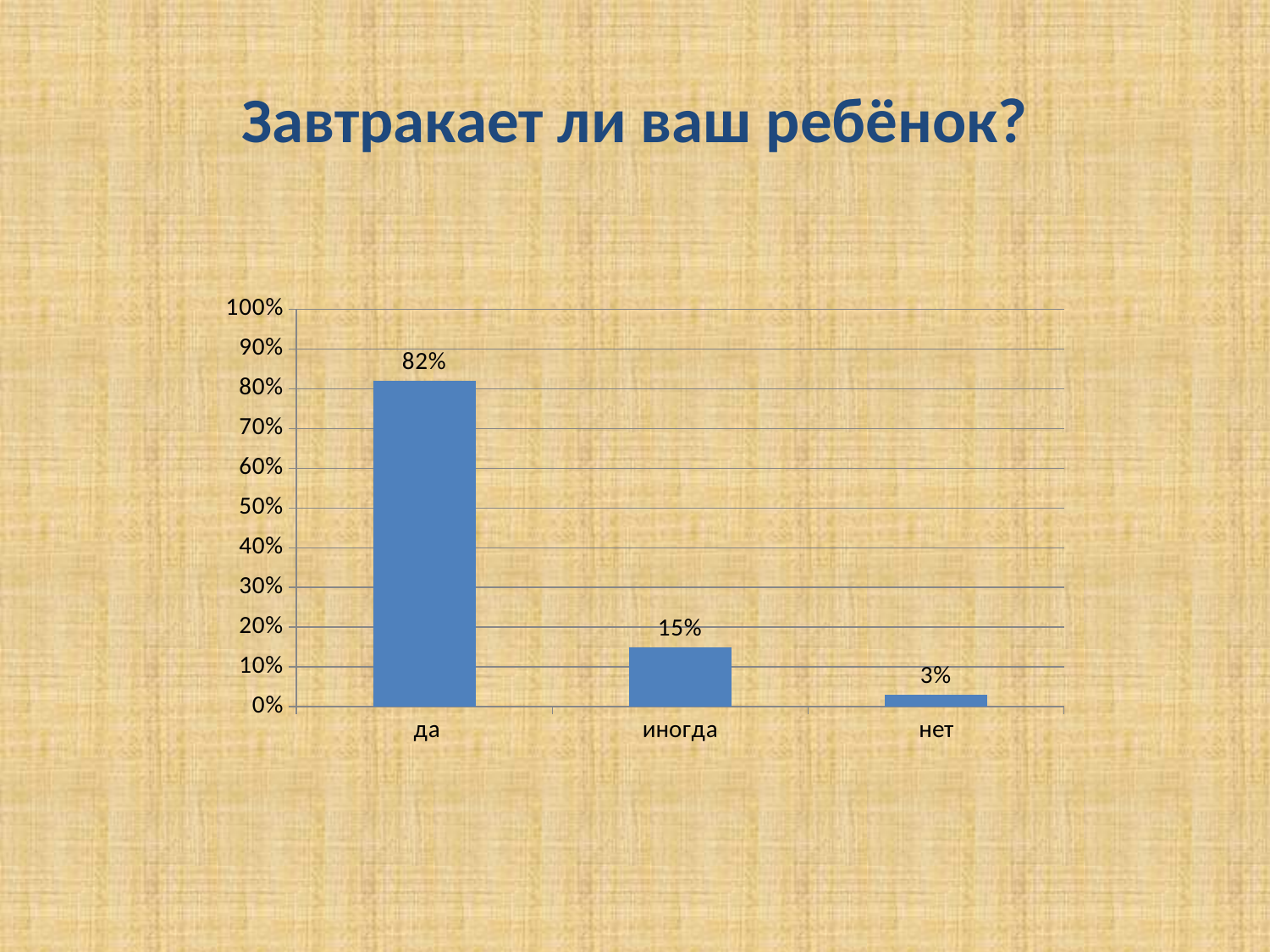
Which category has the highest value? да What is the value for "да"? 82% Which category has the lowest value? нет How many categories are shown on the x axis? 3 What kind of chart is shown on the slide? bar chart What is the title of the slide? Завтракает ли ваш ребёнок? What is the difference between the values for "иногда" and "нет"? 12% Which is larger, the value for "иногда" or the value for "нет"? иногда Is the value for "да" greater or less than 50%? greater What is the difference between the values for "да" and "иногда"? 67% What is the value for "иногда"? 15% What is the value for "нет"? 3%